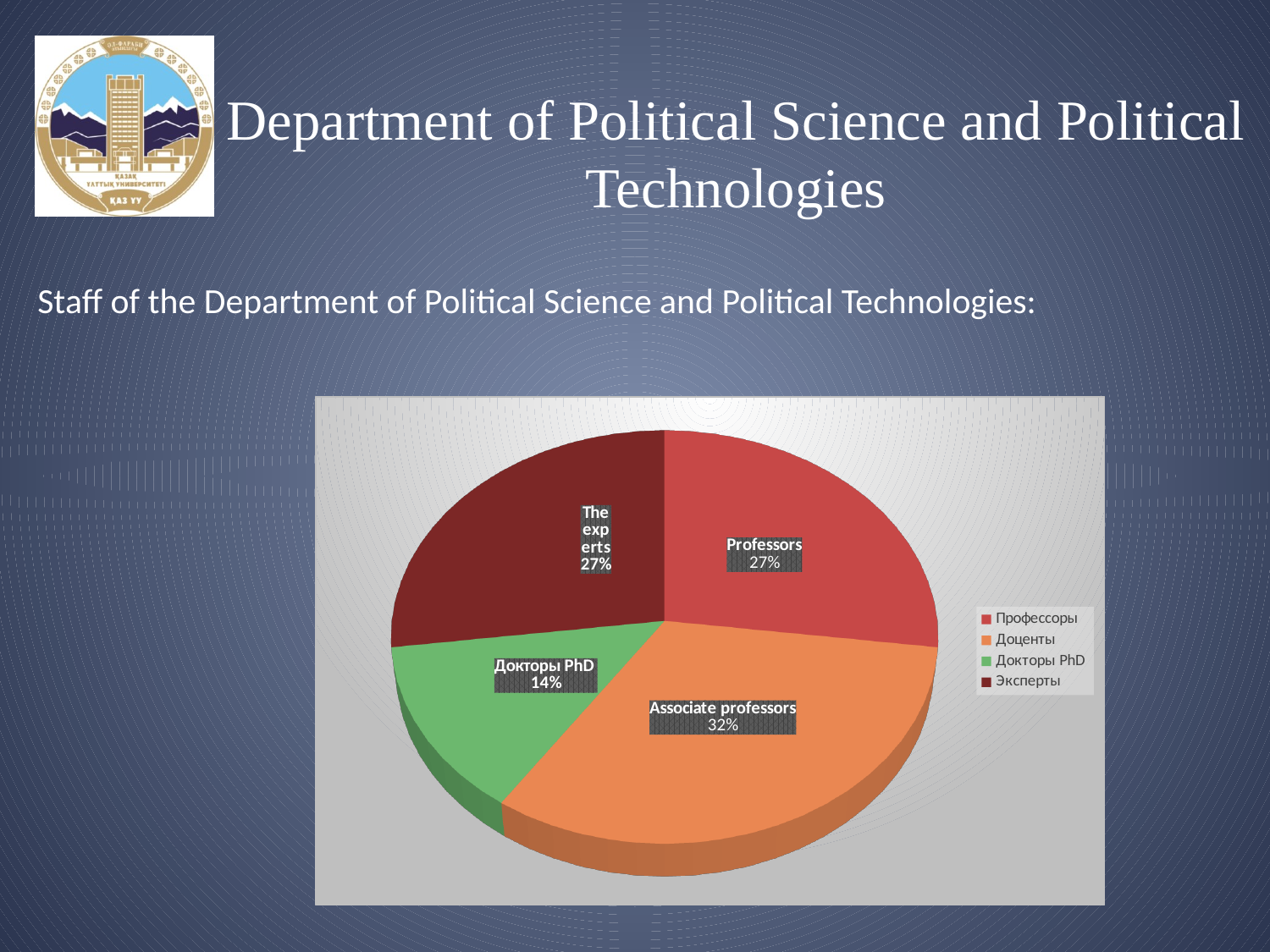
What percentage is shown for the Professors slice? 27% How many slices does the pie chart have? 4 What is the difference in percentage points between the Associate professors slice and the Докторы PhD slice? 18 percentage points How many entries does the chart legend list? 4 Which slice is larger, Associate professors or Professors? Associate professors What kind of chart is shown on the slide? Pie chart What share of the pie does the Associate professors slice represent? 32% What percentage is shown for the Докторы PhD slice? 14% What colour is the Associate professors slice in the pie chart? Orange Which category has the largest slice of the pie? Associate professors Which category has the smallest slice of the pie? Докторы PhD What percentage is shown for The experts slice? 27%